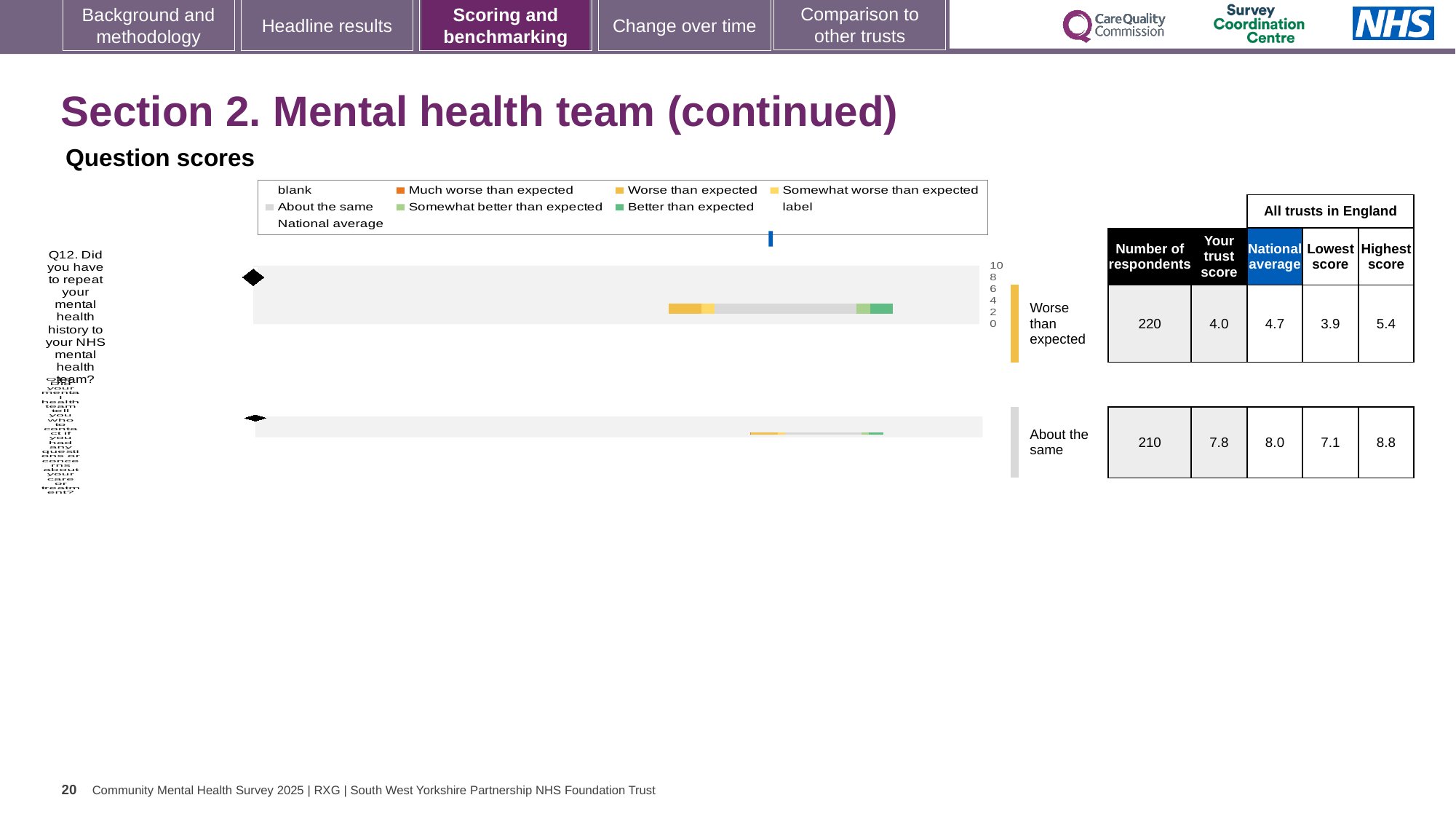
How many questions are plotted in the question scores chart? 2 Which colour in the legend represents 'Better than expected'? green How many respondents answered Q12? 220 What is the national average score for Q12? 4.7 What is the trust score for the second question row (the one rated 'About the same')? 7.8 What is the difference between the highest and lowest trust scores in England for Q12? 1.5 What is the trust score for Q12 (repeating mental health history to the NHS mental health team)? 4.0 Is the trust score for Q12 higher or lower than the national average? lower What is the difference between the national average and the trust score for Q12? 0.7 What benchmark category is Q12 placed in? Worse than expected What is the highest score among all trusts in England for the second question row? 8.8 What kind of chart is used to show the question scores on this slide? bar chart